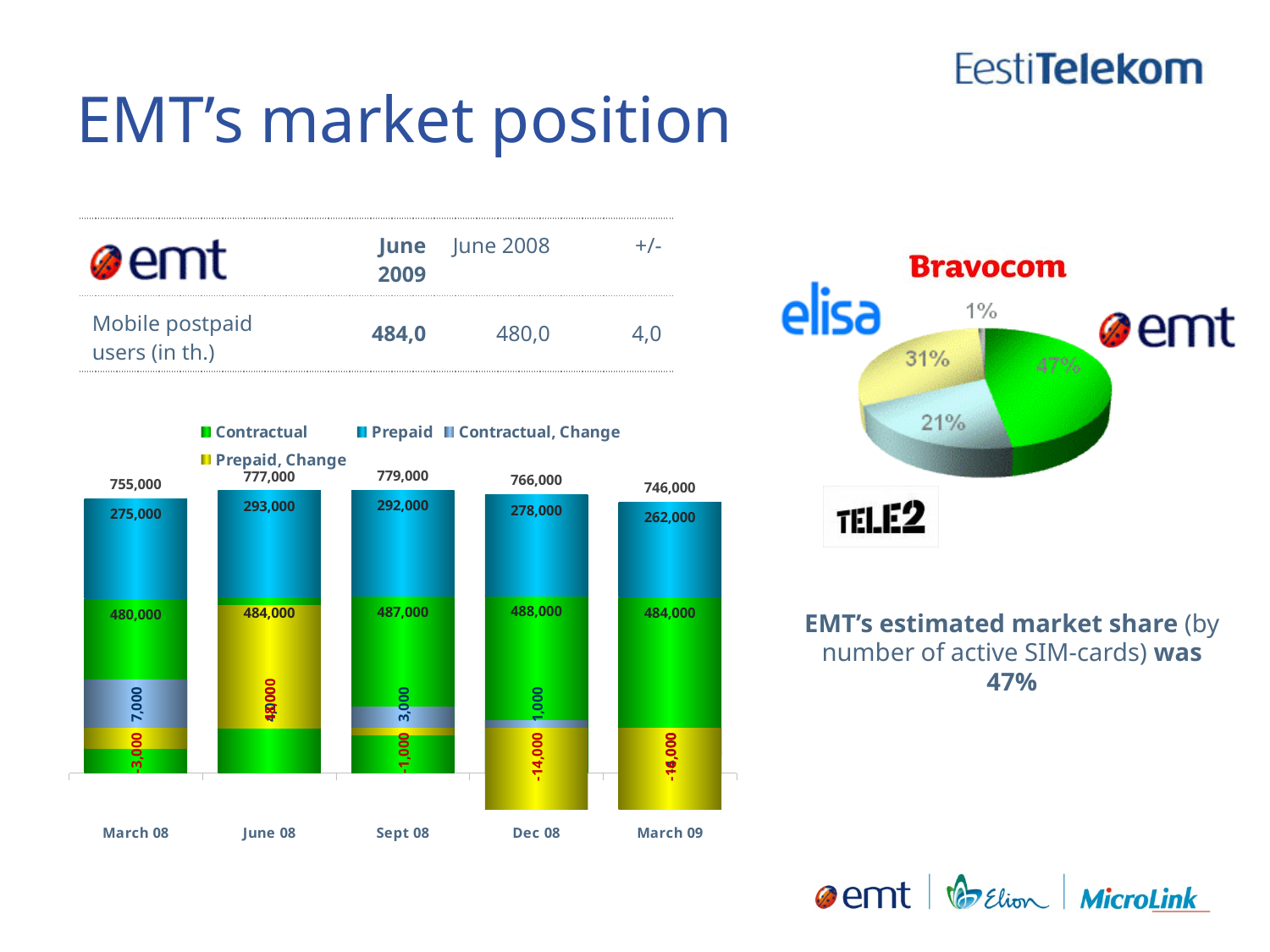
In the bar chart on the left, which period has the lowest total shown above its bar? March 09 In the bar chart on the left, what is the Contractual value for Dec 08? 488,000 How many series does the legend of the bar chart on the left list? 4 In the bar chart on the left, is the Prepaid value larger for March 08 or March 09? March 08 In the pie chart on the right, what is EMT's market share? 47% In the bar chart on the left, which period has the highest total shown above its bar? Sept 08 In the bar chart on the left, what is the difference between the Contractual values for Sept 08 and March 08? 7,000 In the bar chart on the left, what is the Prepaid value for June 08? 293,000 In the bar chart on the left, what is the total shown above the June 08 bar? 777,000 How many time periods are shown on the x axis of the bar chart on the left? 5 In the pie chart on the right, what is the share of the smallest slice? 1% What kind of chart is the chart on the left of the slide? bar chart